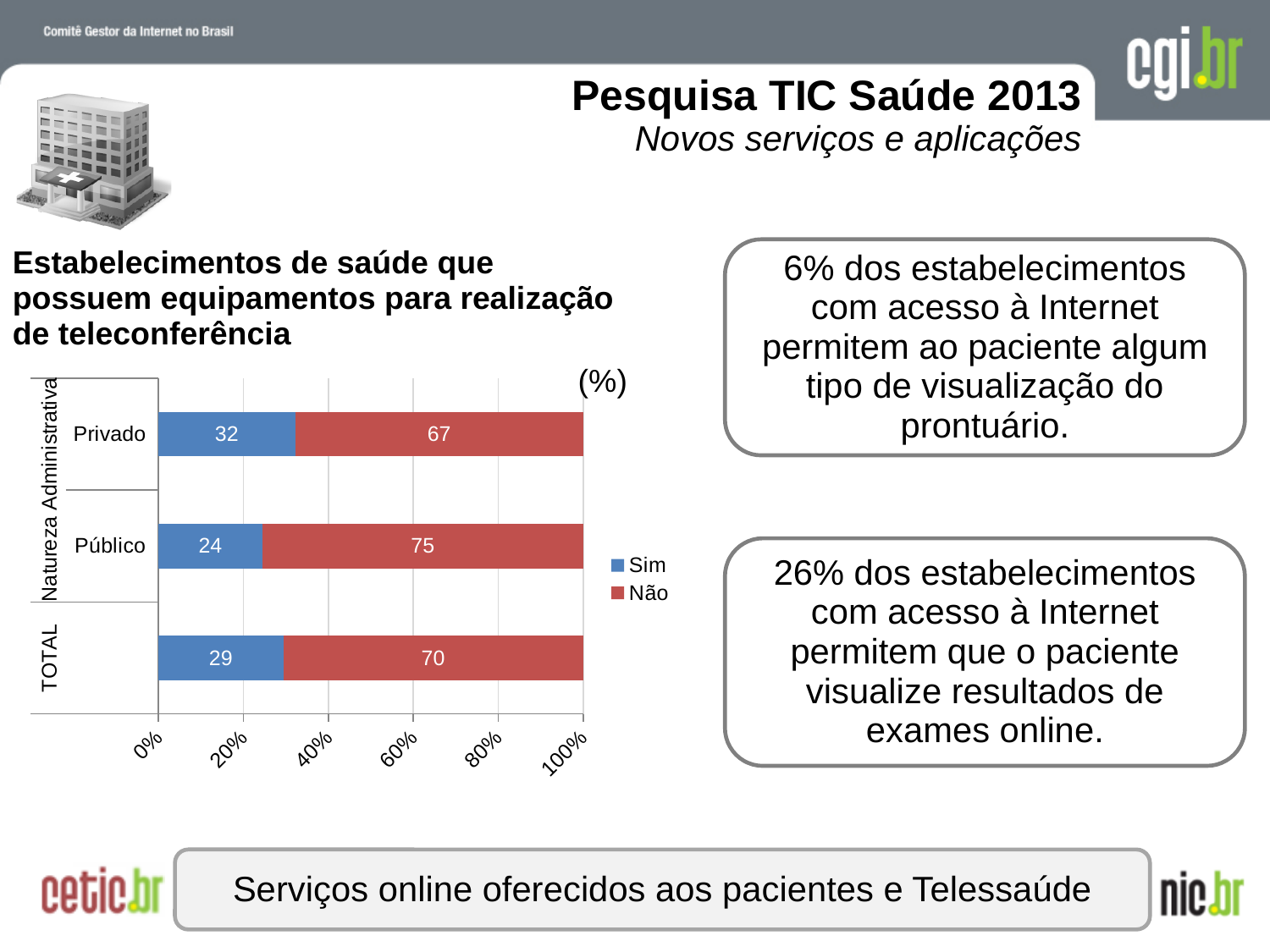
How many categories are shown on the chart? 3 What is the total of the stacked bar for Público? 99 Is the 'Não' value for Privado greater or less than 60%? greater How many series does the legend list? 2 What is the 'Não' value for Público? 75 Which category has the highest 'Sim' value? Privado What is the 'Sim' value for TOTAL? 29 What kind of chart is shown? Stacked bar chart What is the 'Sim' value for Privado? 32 Which is larger, the 'Sim' value for Privado or the 'Sim' value for TOTAL? Privado What is the difference between the 'Não' values for Público and Privado? 8 Which category has the lowest 'Sim' value? Público